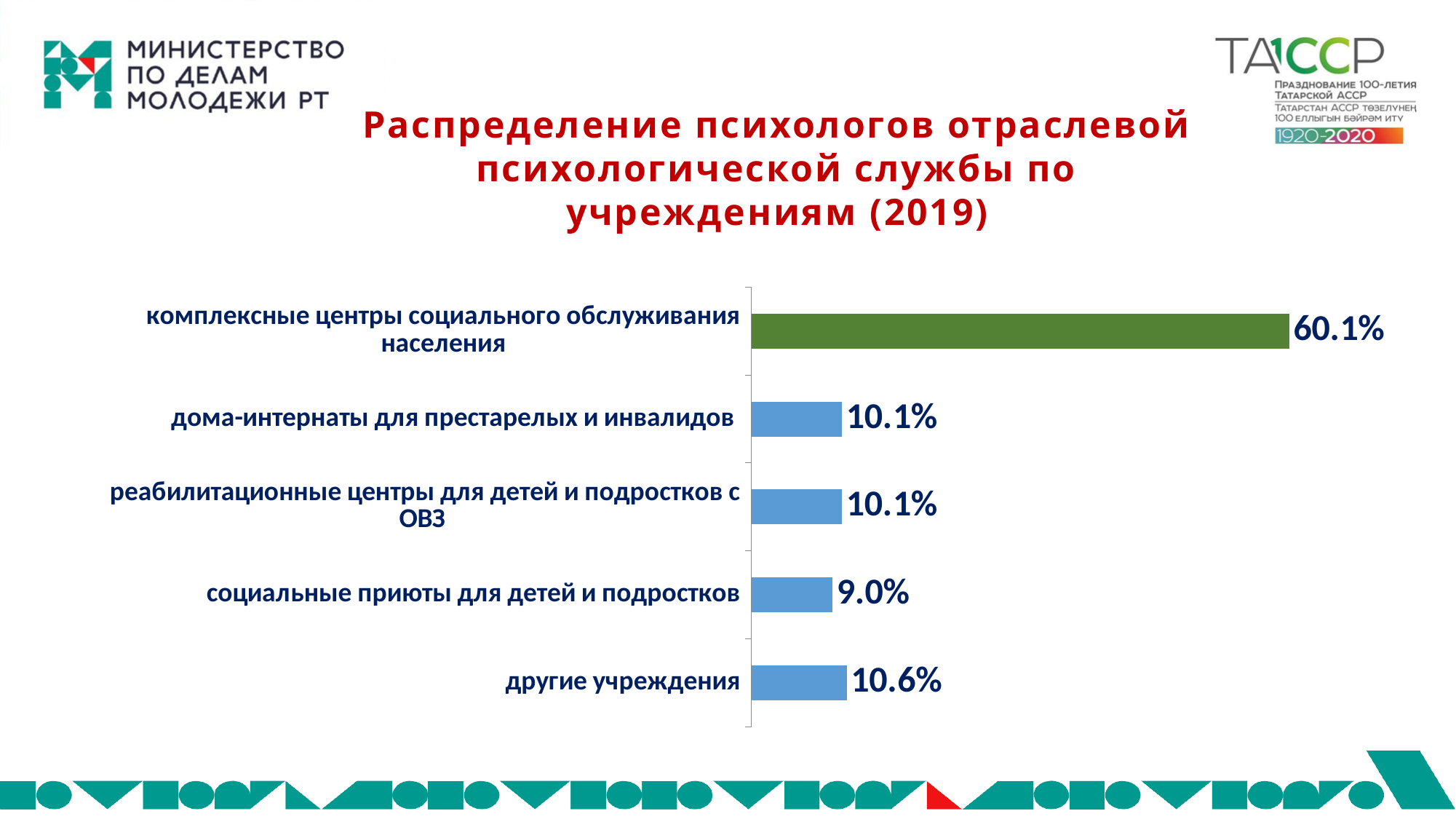
Which category has the highest value? комплексные центры социального обслуживания населения What is the title of the chart? Распределение психологов отраслевой психологической службы по учреждениям (2019) What is the value for комплексные центры социального обслуживания населения? 60.1% What kind of chart is shown on the slide? bar chart What is the value for социальные приюты для детей и подростков? 9.0% What is the difference between the values for комплексные центры социального обслуживания населения and другие учреждения? 49.5% Which is larger: the value for другие учреждения or the value for реабилитационные центры для детей и подростков с ОВЗ? другие учреждения Which category has the lowest value? социальные приюты для детей и подростков What is the value for другие учреждения? 10.6% What is the value for дома-интернаты для престарелых и инвалидов? 10.1% What is the difference between the values for другие учреждения and социальные приюты для детей и подростков? 1.6% How many categories are shown in the chart? 5